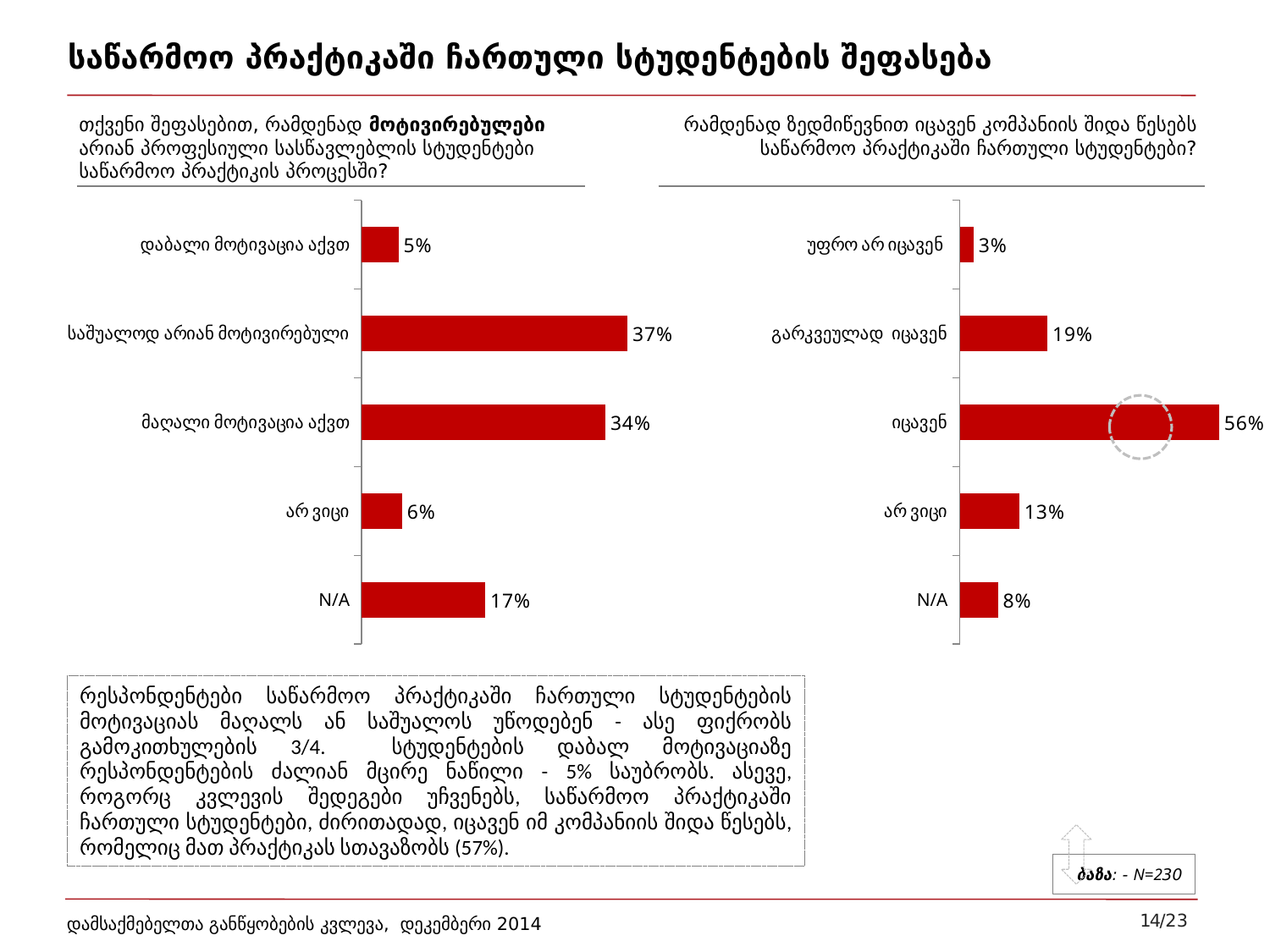
In the right chart, which is larger: "არ ვიცი" or "N/A"? არ ვიცი In the left chart, what is the value for "N/A"? 17% In the right chart, what is the difference between "იცავენ" and "გარკვეულად იცავენ"? 37% In the right chart, which category has the highest value? იცავენ In the left chart, what is the difference between "საშუალოდ არიან მოტივირებული" and "მაღალი მოტივაცია აქვთ"? 3% In the left chart, which category has the lowest value? დაბალი მოტივაცია აქვთ In the left chart, what is the value for "საშუალოდ არიან მოტივირებული"? 37% What type of chart is the left chart? Bar chart In the right chart, what is the value for "გარკვეულად იცავენ"? 19% In the left chart, how many categories are shown? 5 In the right chart, which category has the lowest value? უფრო არ იცავენ In the right chart, what is the value for "იცავენ"? 56%